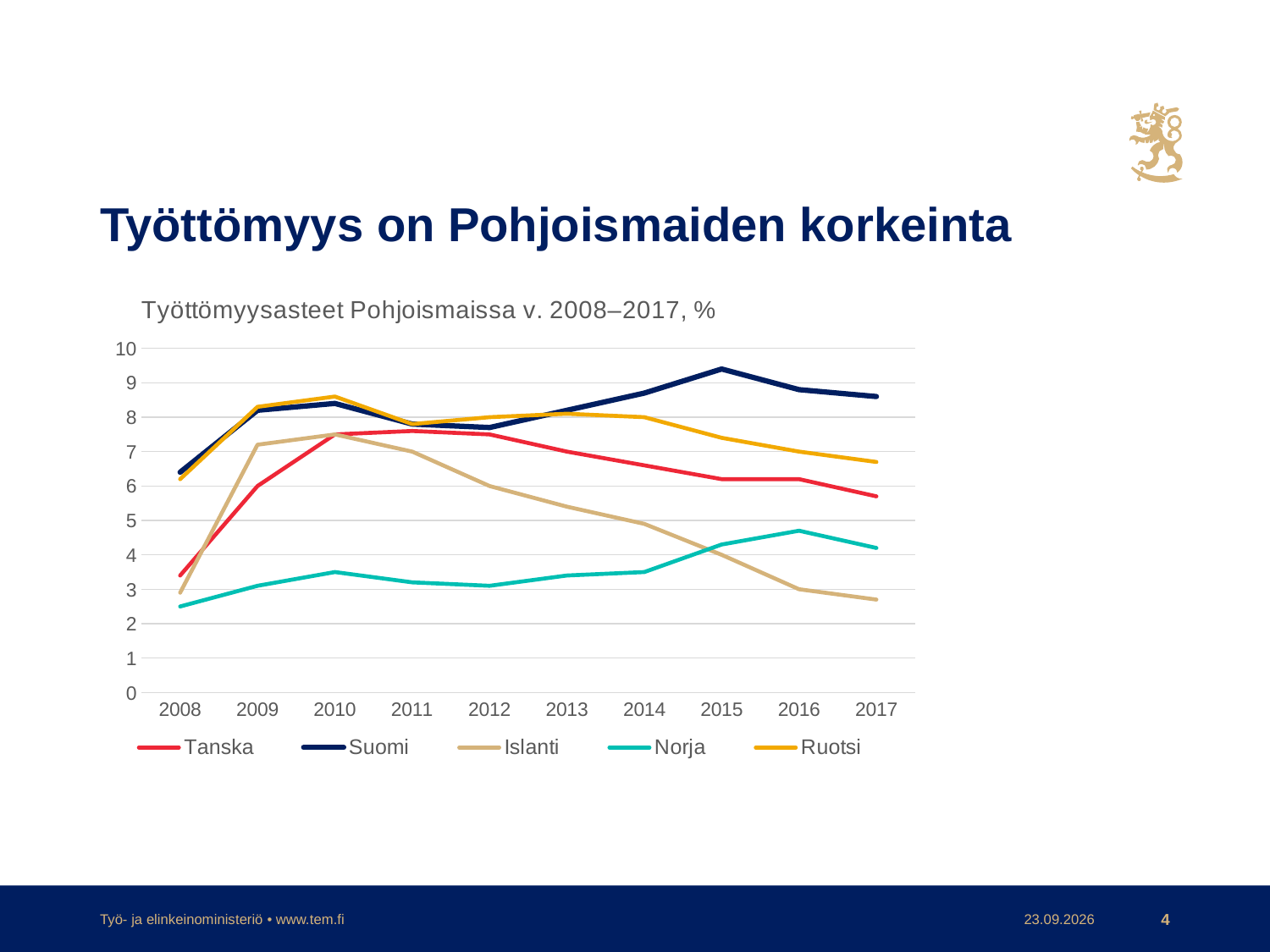
What is the title of the chart? Työttömyysasteet Pohjoismaissa v. 2008–2017, % What kind of chart is shown on the slide? line chart Is the value for Suomi in 2015 greater or less than 9? greater Which country has the highest unemployment rate in 2017? Suomi Does the value for Islanti rise or fall from 2010 to 2017? fall How many series does the legend list? 5 Which country has the lowest unemployment rate in 2017? Islanti Is the value for Islanti in 2017 greater or less than 3? less How many years are shown on the x axis? 10 Which is larger in 2017, the value for Norja or the value for Islanti? Norja Is the value for Tanska in 2008 greater or less than 4? less Which country has the highest unemployment rate in 2015? Suomi